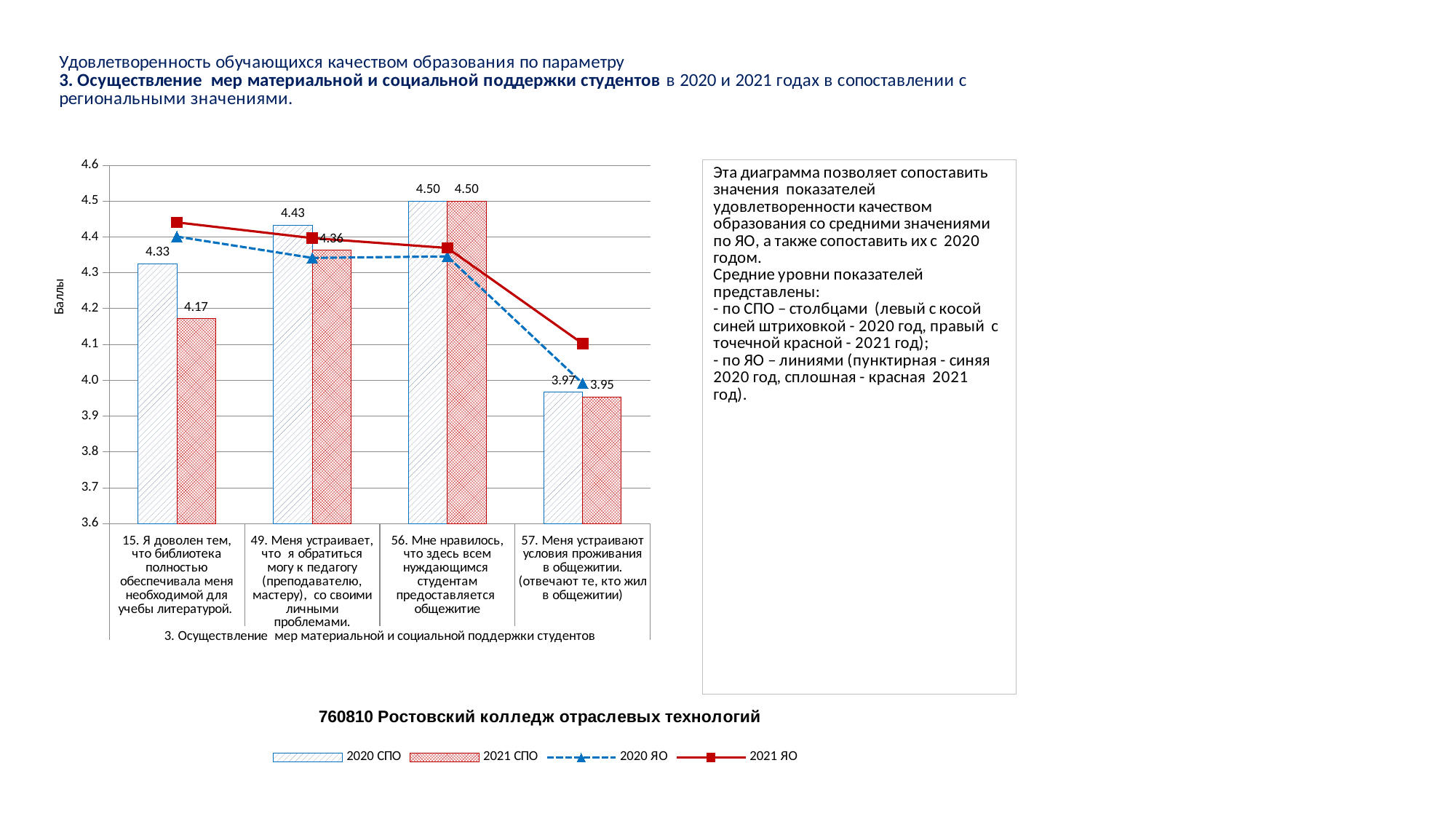
What is the value of the 2020 СПО bar for category "15. Я доволен тем, что библиотека полностью обеспечивала меня необходимой для учебы литературой."? 4.33 For category 49 (turning to a teacher with personal problems), which is larger: the 2020 СПО value or the 2021 СПО value? 2020 СПО Is the 2021 ЯО value for category 57 (dormitory living conditions) greater or less than 4.2? less What is the title of the vertical axis of the chart? Баллы What is the value of the 2021 СПО bar for category "57. Меня устраивают условия проживания в общежитии"? 3.95 Does the 2021 ЯО line rise or fall from left to right across the categories? falls Which category has the highest 2021 СПО value? 56. Мне нравилось, что здесь всем нуждающимся студентам предоставляется общежитие How many series does the chart legend list? 4 How many categories are shown on the x axis of the chart? 4 Which category has the lowest 2020 СПО value? 57. Меня устраивают условия проживания в общежитии Is the 2020 ЯО value for category 15 (library literature) greater or less than 4.3? greater What is the difference between the 2020 СПО and 2021 СПО values for category 15 (library literature)? 0.16